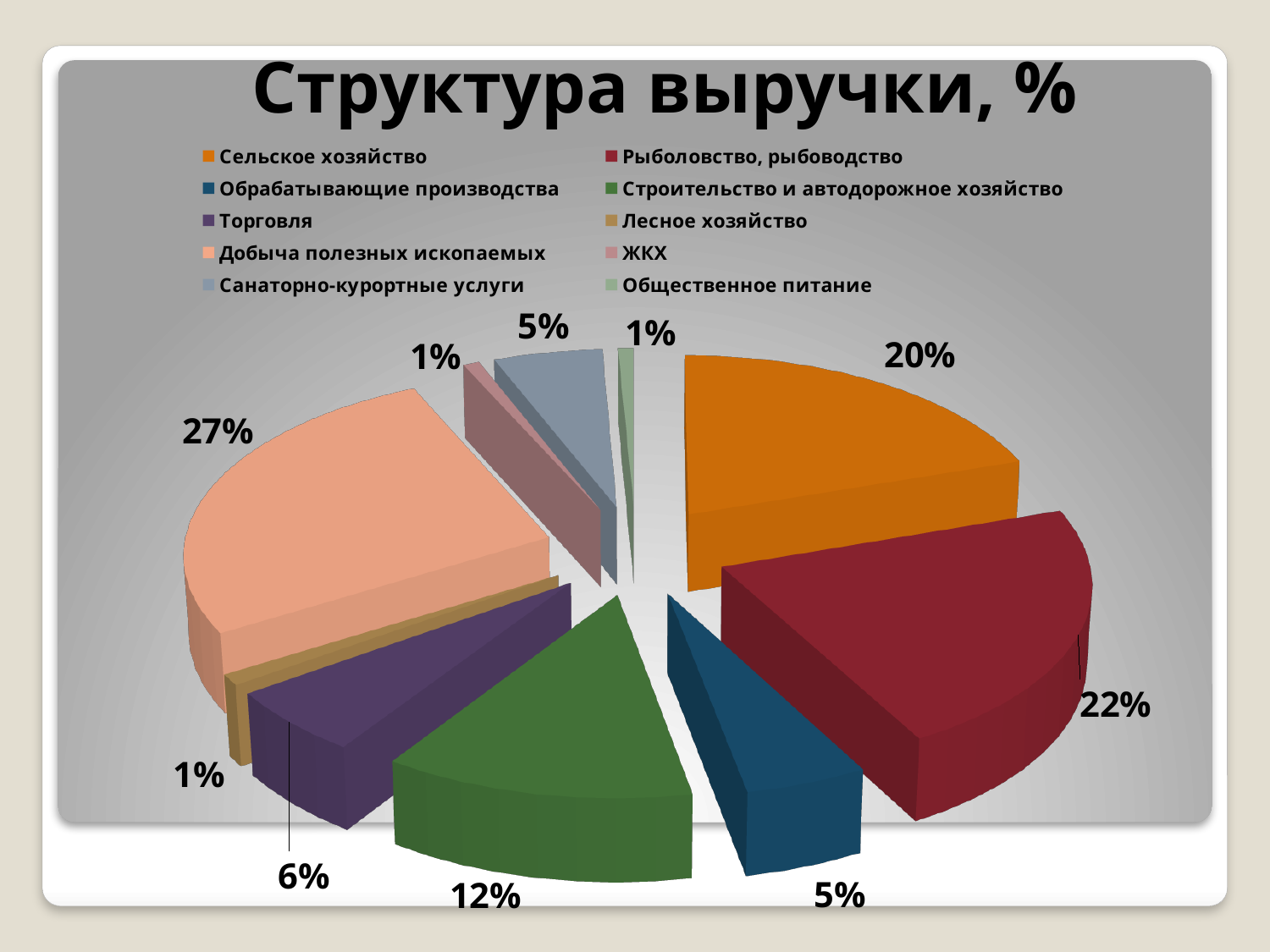
What is the value for Строительство и автодорожное хозяйство? 12% What type of chart is shown on the slide? pie chart What is the difference between the shares of Добыча полезных ископаемых and Строительство и автодорожное хозяйство? 15% Which colour represents Санаторно-курортные услуги in the legend? grey-blue What is the value for Рыболовство, рыбоводство? 22% Which category has the largest share of the pie? Добыча полезных ископаемых What is the value for Сельское хозяйство? 20% How many categories does the legend list? 10 What is the value for Торговля? 6% What share of revenue does Добыча полезных ископаемых account for? 27% What is the title of the chart? Структура выручки, % Which is larger, Рыболовство, рыбоводство or Сельское хозяйство? Рыболовство, рыбоводство